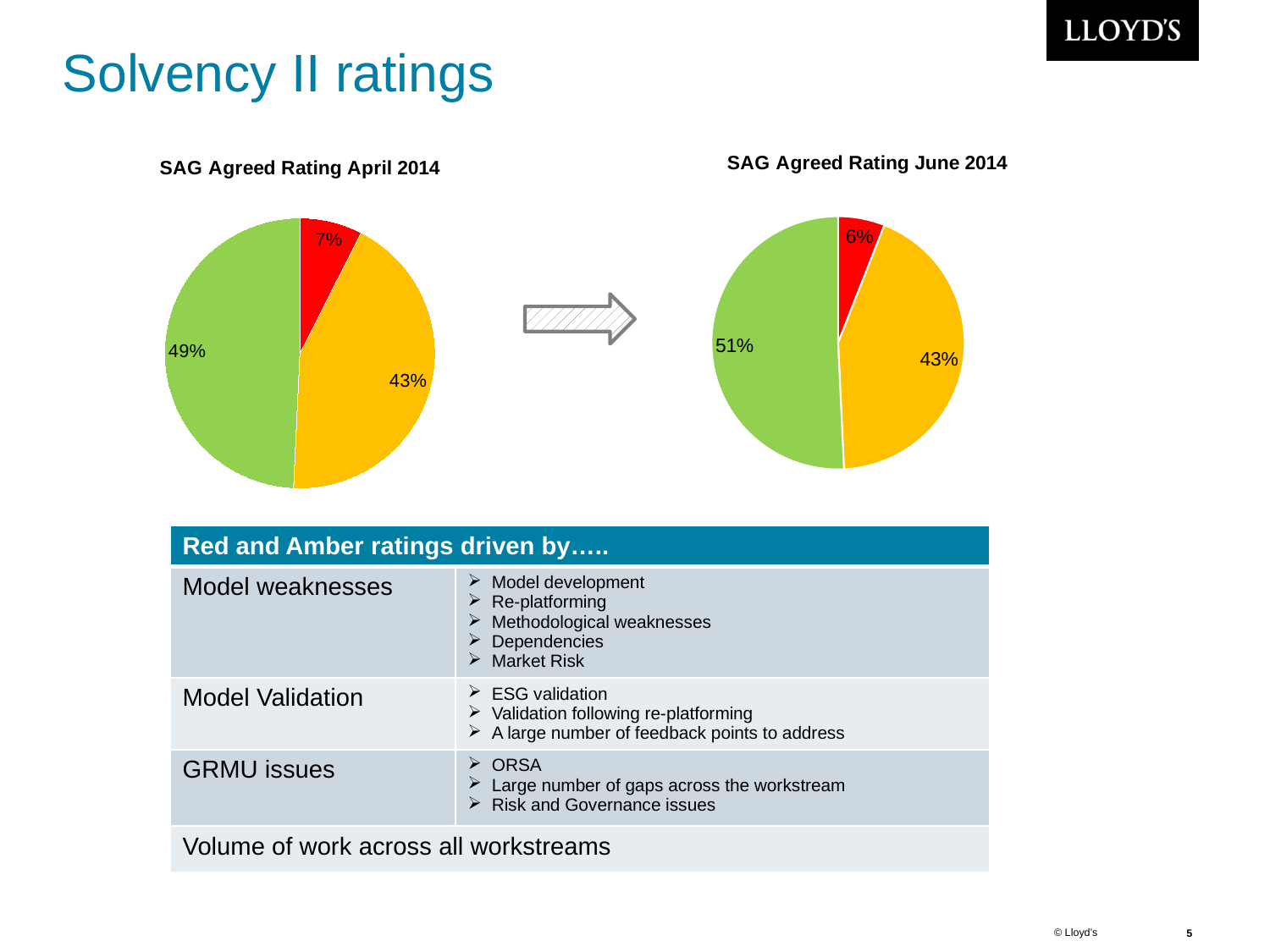
By how many percentage points did the green share change from the April 2014 chart to the June 2014 chart? 2 percentage points In the SAG Agreed Rating June 2014 pie chart, what share does the amber slice represent? 43% What type of chart is used to show the SAG Agreed Rating April 2014? Pie chart How many pie charts are shown on the slide? 2 How many slices does the SAG Agreed Rating June 2014 pie chart have? 3 In the SAG Agreed Rating April 2014 pie chart, what share does the red slice represent? 7% Is the red slice larger in the April 2014 chart or the June 2014 chart? April 2014 In the SAG Agreed Rating April 2014 pie chart, which colour slice is the largest? Green In the SAG Agreed Rating June 2014 pie chart, what share does the green slice represent? 51% What is the title of the chart on the right side of the slide? SAG Agreed Rating June 2014 In the SAG Agreed Rating June 2014 pie chart, which colour slice is the smallest? Red In the SAG Agreed Rating April 2014 pie chart, what is the difference between the green and amber shares? 6 percentage points